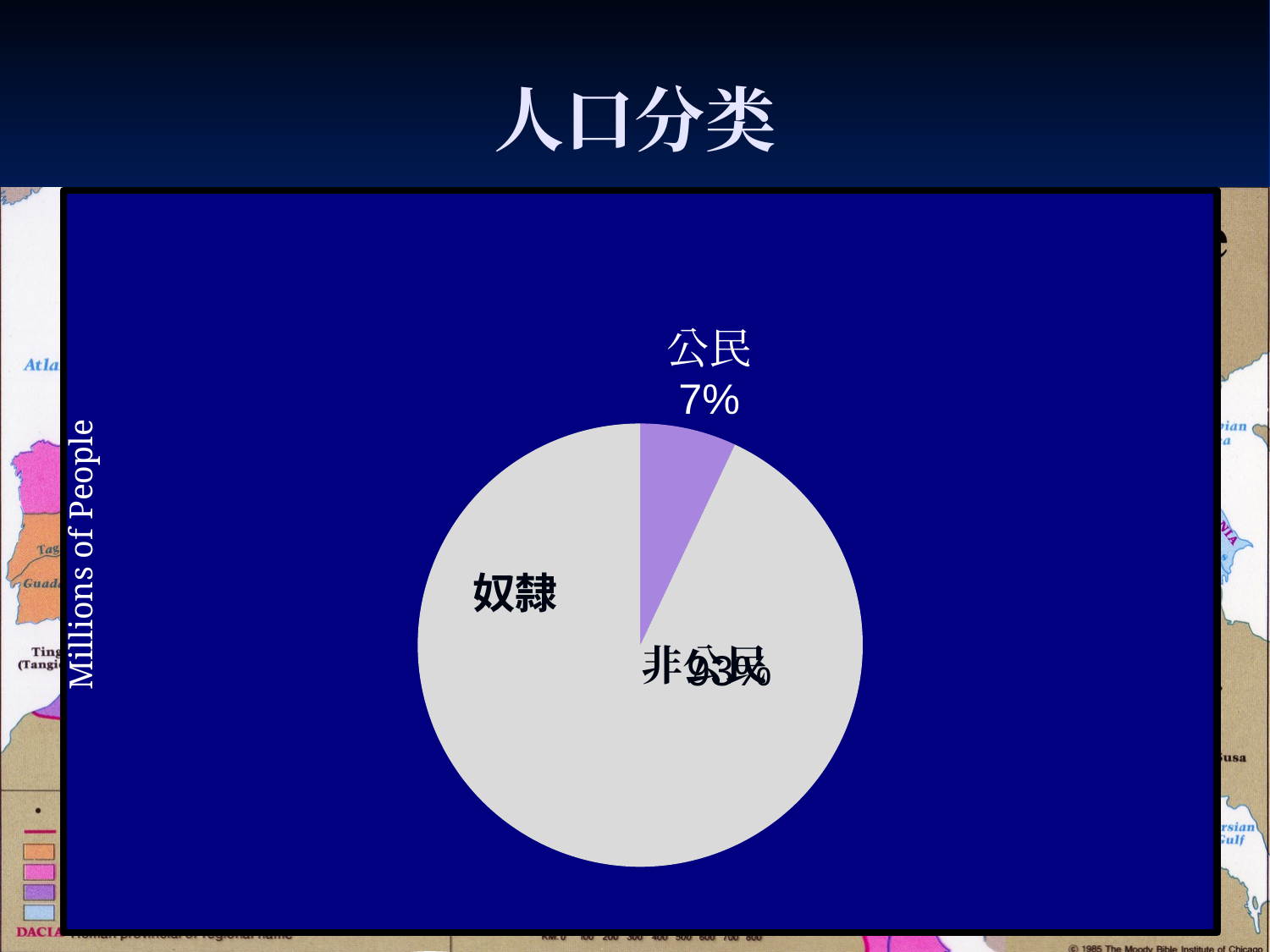
Which slice is larger, 公民 or 奴隸? 奴隸 Which slice of the pie is the largest? 奴隸 What kind of chart is shown on the slide? pie chart Is the share of the 奴隸 slice greater or less than 50%? greater What is the title of the slide containing the pie chart? 人口分类 Which slice of the pie is the smallest? 公民 What share of the pie does the 公民 slice represent? 7% What colour is the 公民 slice of the pie? purple Is the share of the 公民 slice greater or less than 10%? less